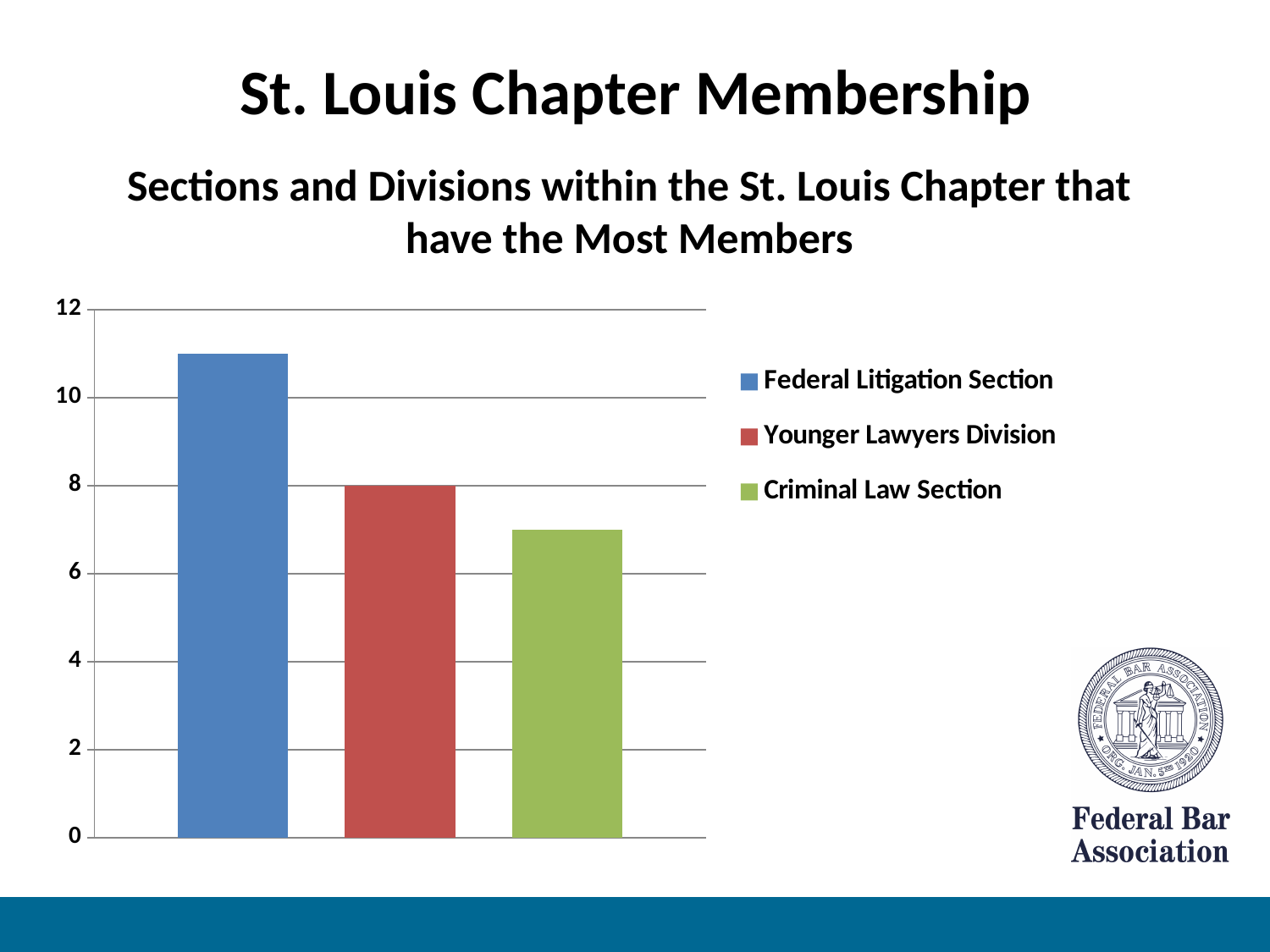
Is the value for the Criminal Law Section greater or less than 6? greater Which is larger, the value for the Federal Litigation Section or the Younger Lawyers Division? Federal Litigation Section Is the value for the Federal Litigation Section greater or less than 10? greater What kind of chart is shown on the slide? bar chart How many bars are plotted in the chart? 3 What is the value for the Younger Lawyers Division? 8 What colour is the bar for the Younger Lawyers Division? red Do the bar values rise or fall from left to right across the chart? fall Which section or division has the lowest value in the chart? Criminal Law Section Which section or division has the highest value in the chart? Federal Litigation Section Is the value for the Criminal Law Section greater or less than 8? less How many entries does the chart's legend list? 3